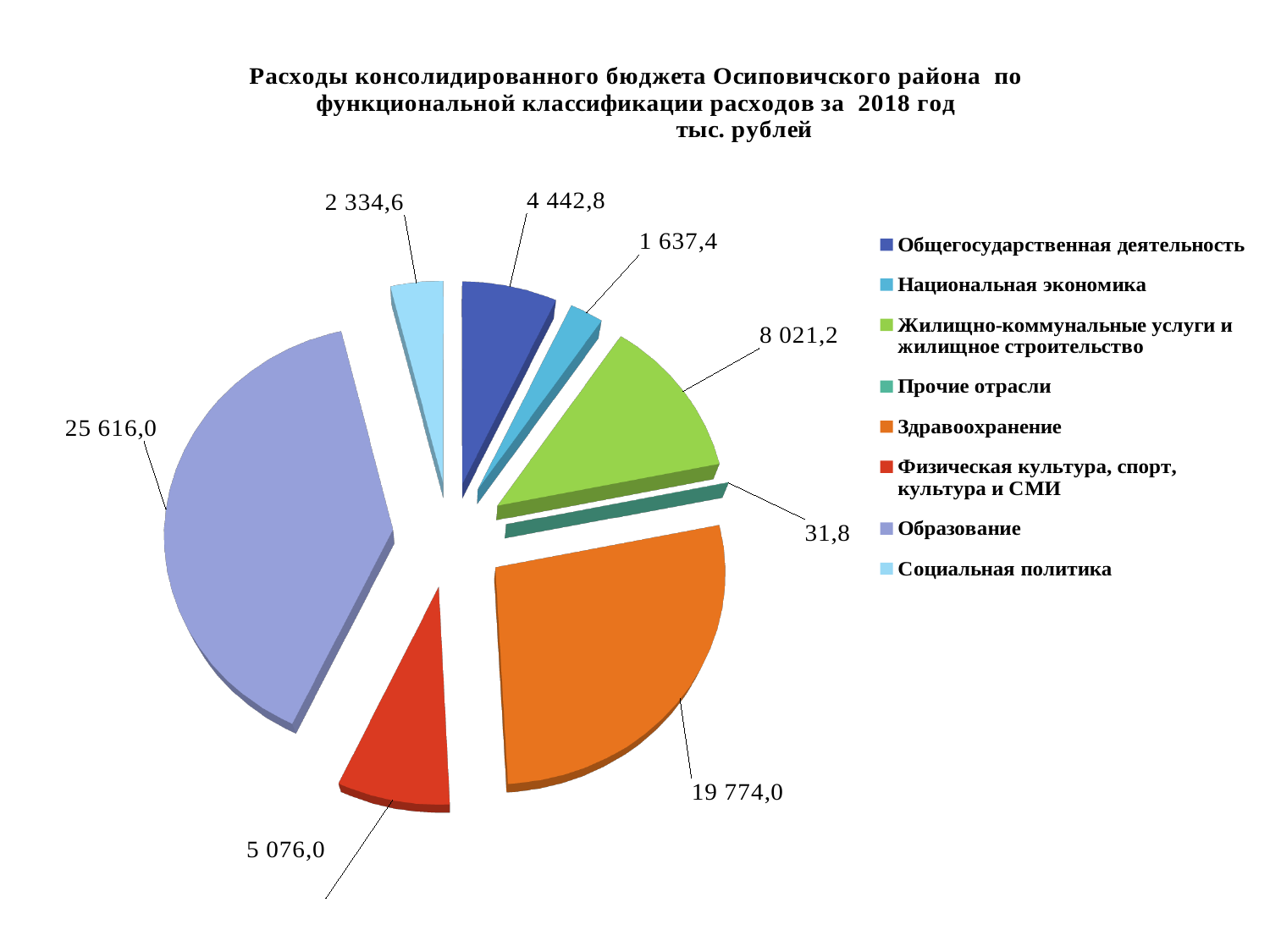
Which category has the smallest value? Прочие отрасли What is the value for Жилищно-коммунальные услуги и жилищное строительство? 8 021,2 What is the value for Здравоохранение? 19 774,0 What is the difference between the values for Образование and Здравоохранение? 5 842,0 What is the value for Образование? 25 616,0 How many slices does the pie chart have? 8 What type of chart is shown on the slide? pie chart Which is larger: the value for Физическая культура, спорт, культура и СМИ or the value for Национальная экономика? Физическая культура, спорт, культура и СМИ Which category has the largest value? Образование What is the difference between the values for Общегосударственная деятельность and Социальная политика? 2 108,2 What is the value for Прочие отрасли? 31,8 What unit is stated in the chart title? тыс. рублей